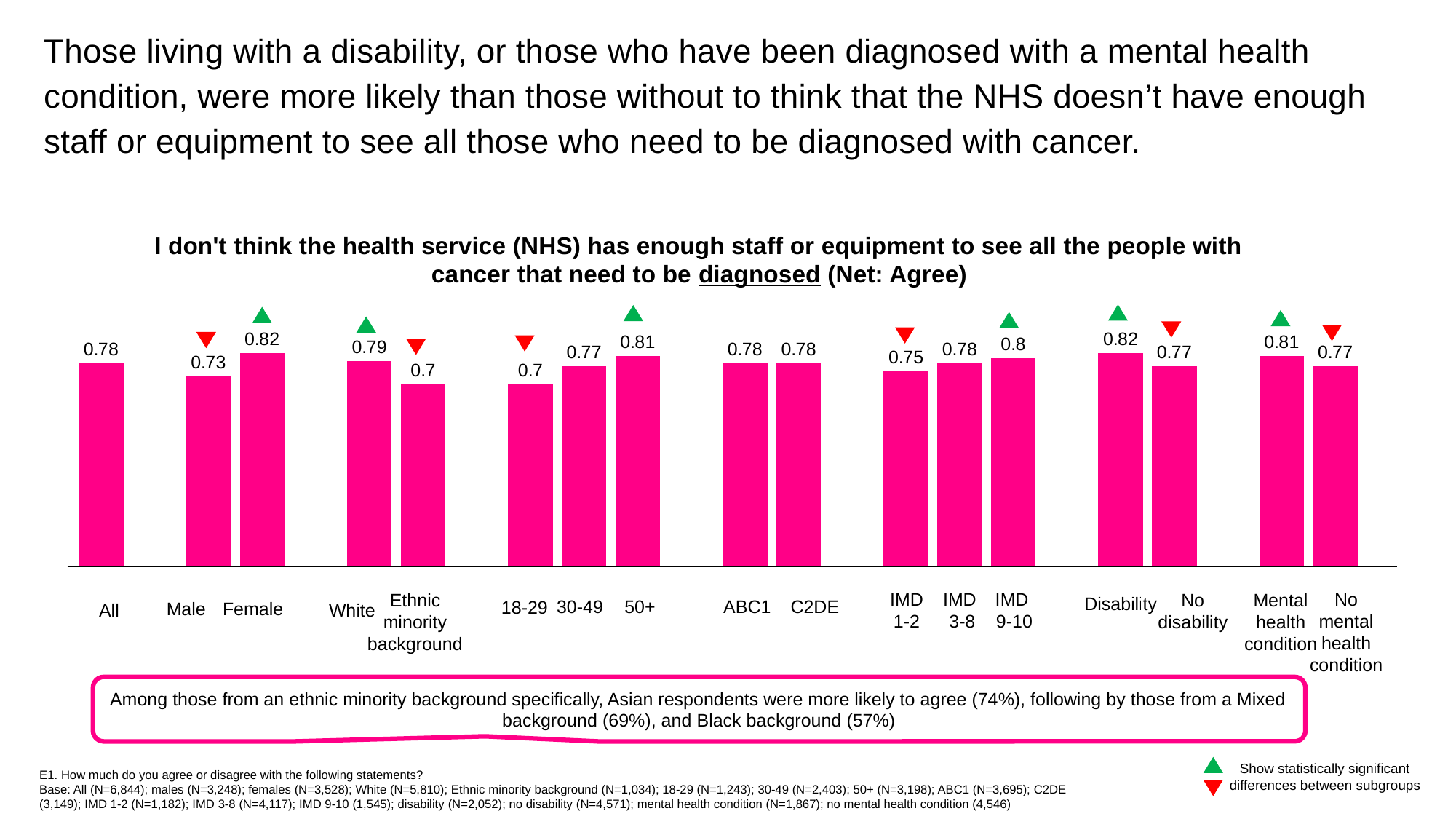
What kind of chart is shown on the slide? Bar chart What is the value for IMD 9-10? 0.8 Which is larger, the value for Mental health condition or the value for No mental health condition? Mental health condition What is the value for Male? 0.73 What is the value for Disability? 0.82 What is the value for the All category? 0.78 What is the value for Ethnic minority background? 0.7 How many bars are plotted in the chart? 17 Do the values rise or fall across the age groups from 18-29 to 50+? Rise What is the difference between the values for Female and Male? 0.09 What is the difference between the values for Disability and No disability? 0.05 Which is larger, the value for 50+ or the value for 18-29? 50+